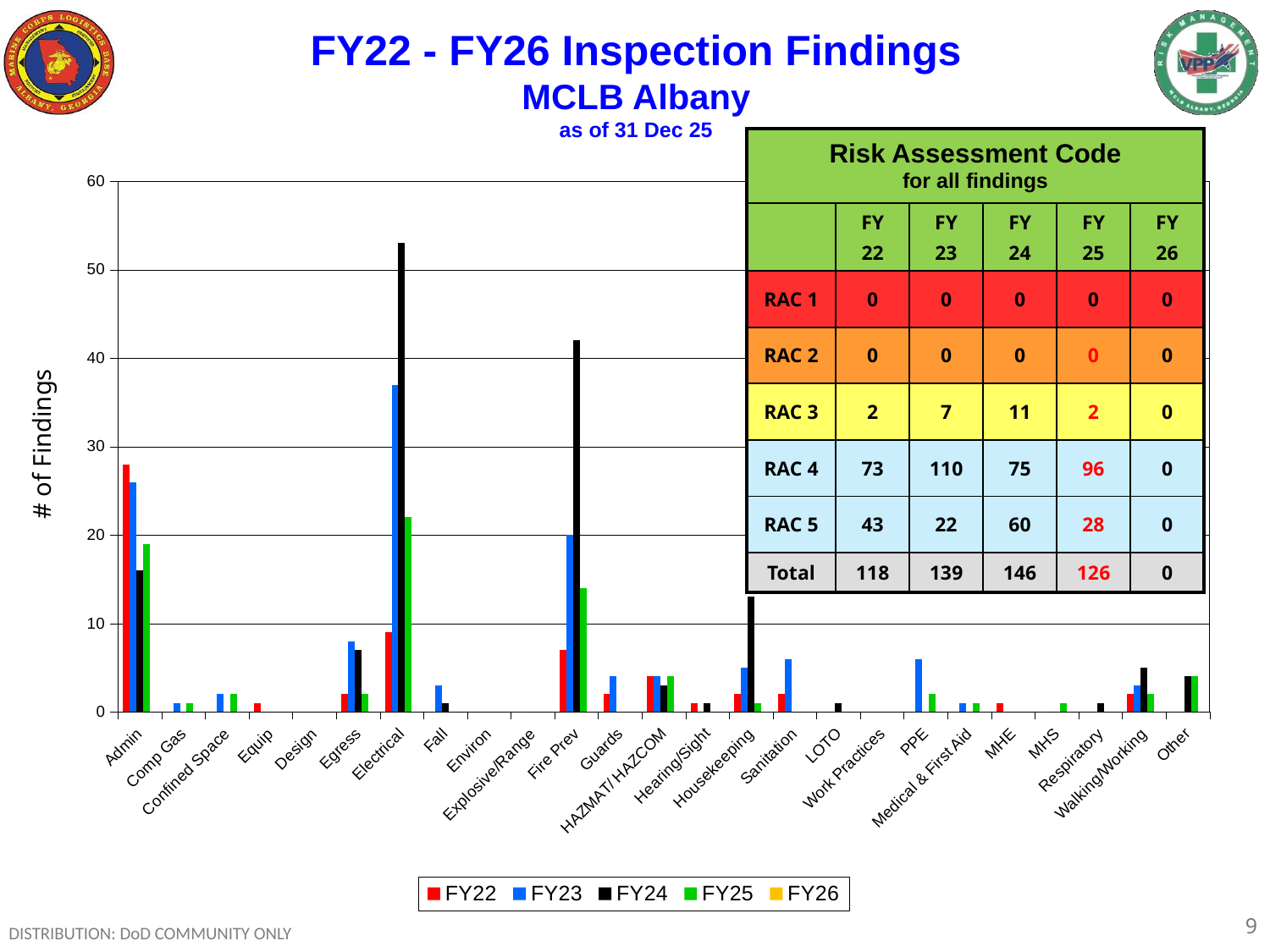
Is the FY24 value for Housekeeping greater or less than 10? greater Which is larger, the FY24 value for Electrical or the FY24 value for Fire Prev? Electrical Is the FY24 value for Electrical greater or less than 50? greater For the Fire Prev category, which series has the tallest bar? FY24 Is the FY23 value for Electrical greater or less than 30? greater How many categories are shown along the x axis of the chart? 25 Which category has the tallest bar in the chart? Electrical What kind of chart is shown on the slide? bar chart What is the label on the vertical axis of the chart? # of Findings How many series does the chart legend list? 5